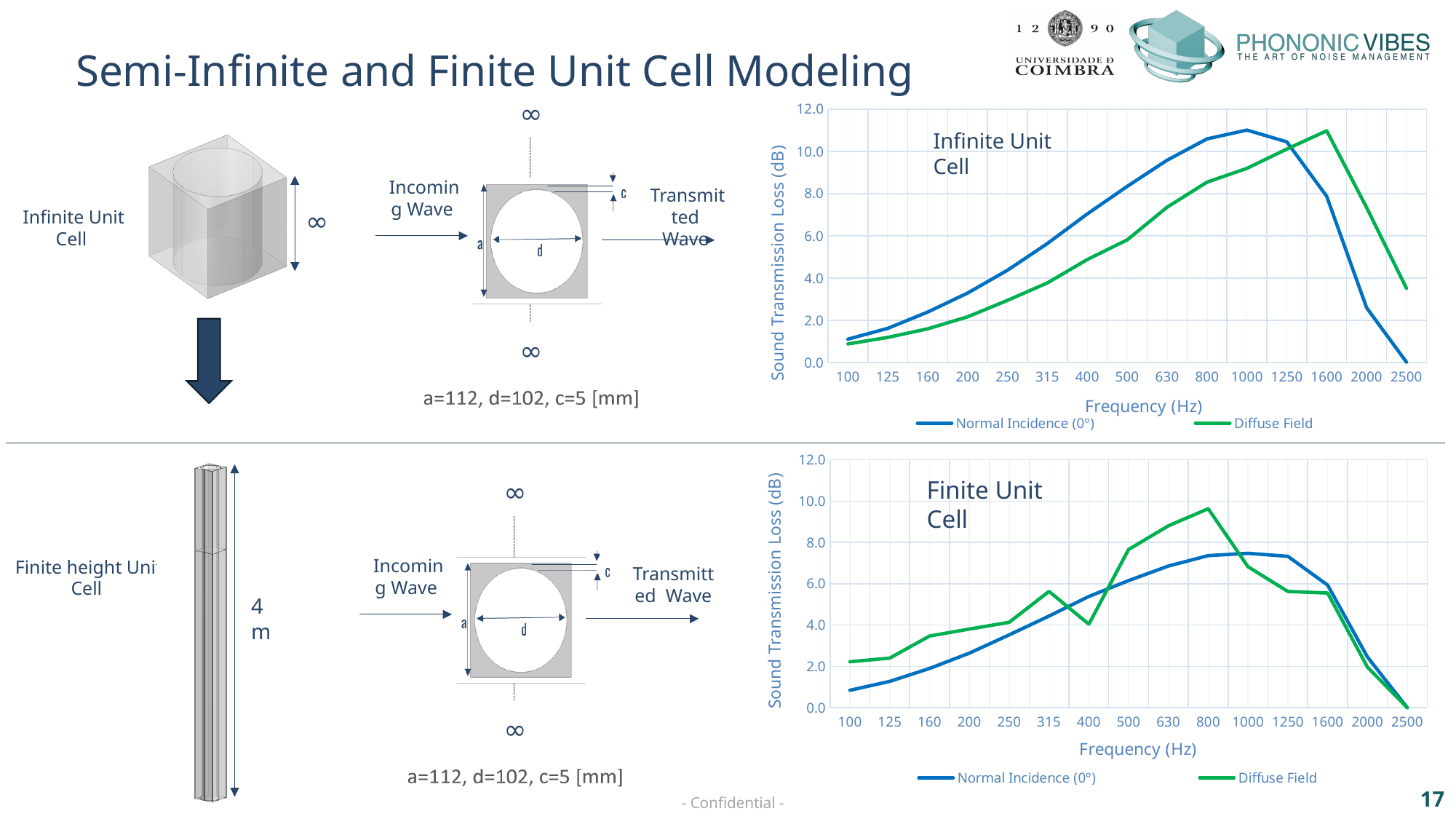
In the Infinite Unit Cell chart, is the Diffuse Field value at 2500 Hz greater or less than 4.0? less What type of chart is the Infinite Unit Cell chart? line chart What is the y-axis label of the Finite Unit Cell chart? Sound Transmission Loss (dB) In the Finite Unit Cell chart, at which frequency does the Diffuse Field series reach its highest value? 800 Hz How many frequency points are shown on the x axis of the Infinite Unit Cell chart? 15 In the Finite Unit Cell chart, which series has the higher value at 160 Hz, Normal Incidence (0°) or Diffuse Field? Diffuse Field How many series does the legend of the Finite Unit Cell chart list? 2 In the Finite Unit Cell chart, is the Normal Incidence (0°) value at 100 Hz greater or less than 2.0? less In the Infinite Unit Cell chart, which series has the higher value at 800 Hz, Normal Incidence (0°) or Diffuse Field? Normal Incidence (0°) In the Finite Unit Cell chart, is the Diffuse Field value at 800 Hz greater or less than 8.0? greater In the Infinite Unit Cell chart, at which frequency does the Normal Incidence (0°) series reach its highest value? 1000 Hz